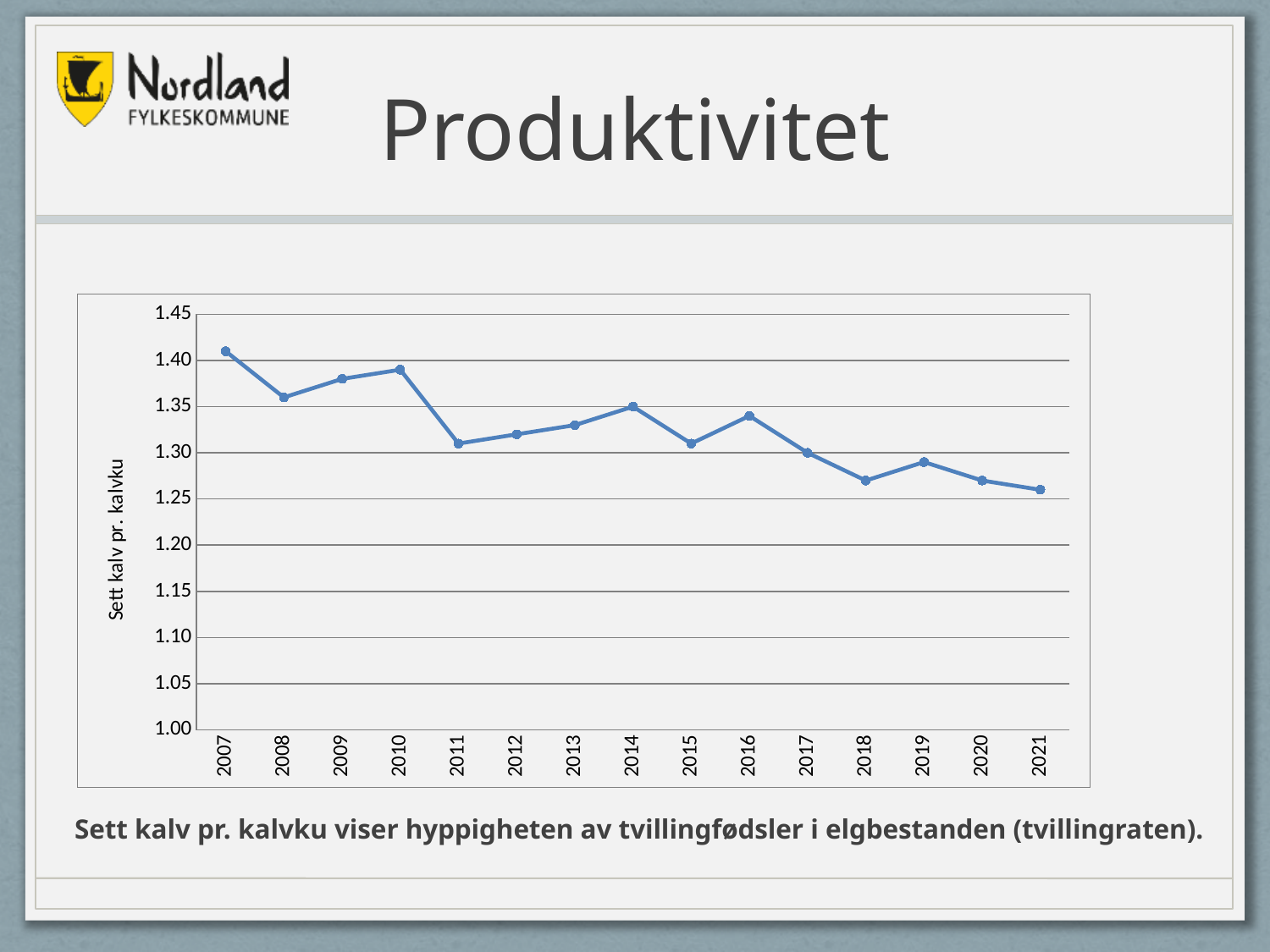
Which year has the larger value, 2007 or 2021? 2007 Is the value for 2018 greater or less than 1.30? less Which year has the highest value in the chart? 2007 How many years are plotted along the x axis of the chart? 15 Is the value for 2007 greater or less than 1.35? greater What kind of chart is shown on the slide? line chart Is the value for 2011 greater or less than 1.35? less What is the label on the vertical axis of the chart? Sett kalv pr. kalvku Overall, do the values rise or fall from 2007 to 2021? fall Which year has the larger value, 2010 or 2011? 2010